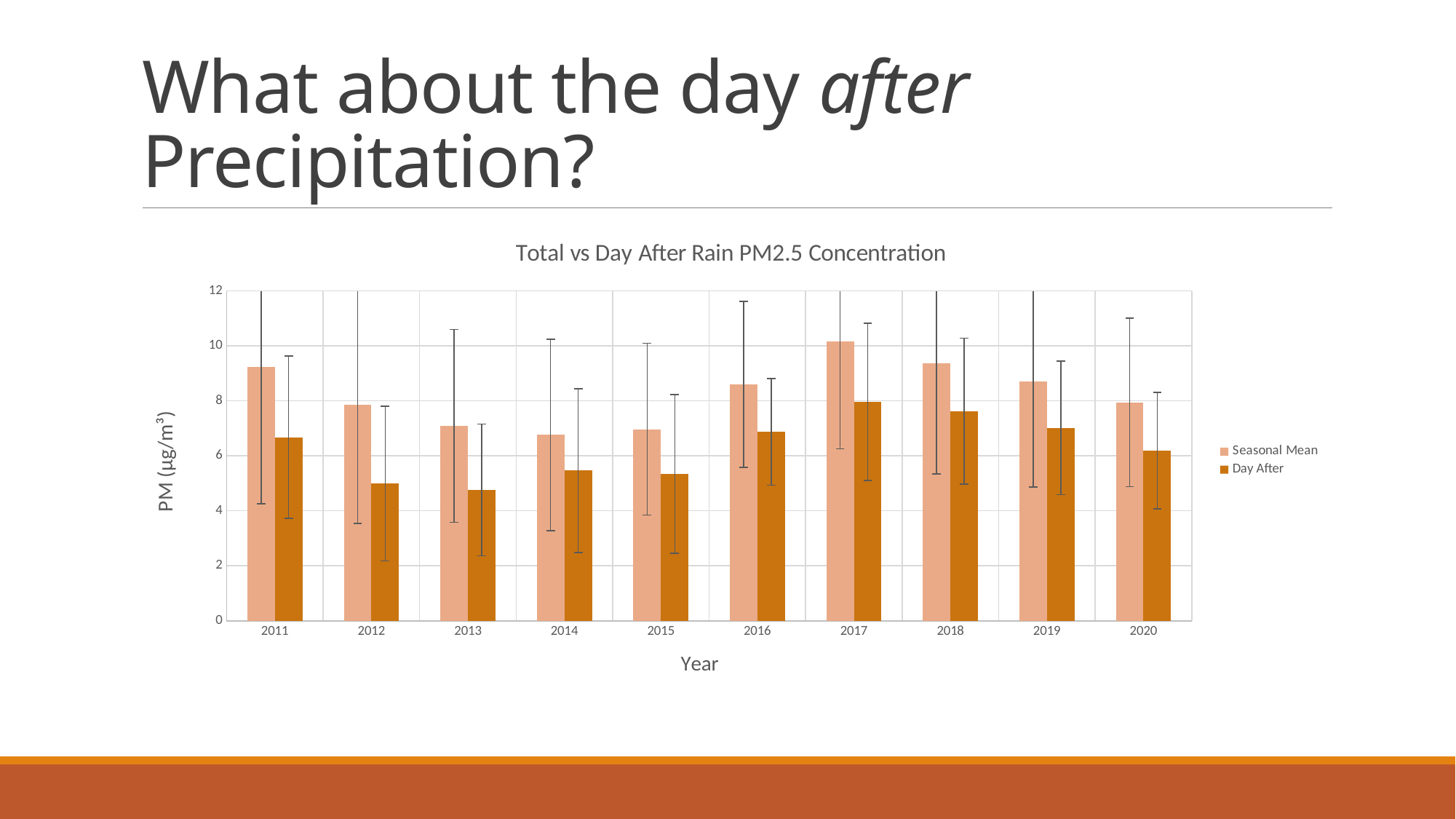
How many years are shown on the x axis of the chart? 10 What is the label on the y axis of the chart? PM (µg/m³) In 2011, which is larger: the Seasonal Mean value or the Day After value? Seasonal Mean Is the Day After value for 2013 greater or less than 6? less Is the Day After value for 2017 greater or less than 6? greater How many series does the chart's legend list? 2 Is the Seasonal Mean value for 2014 greater or less than 8? less Which year has the highest Seasonal Mean value? 2017 What kind of chart is shown on the slide? Bar chart What is the title of the chart? Total vs Day After Rain PM2.5 Concentration